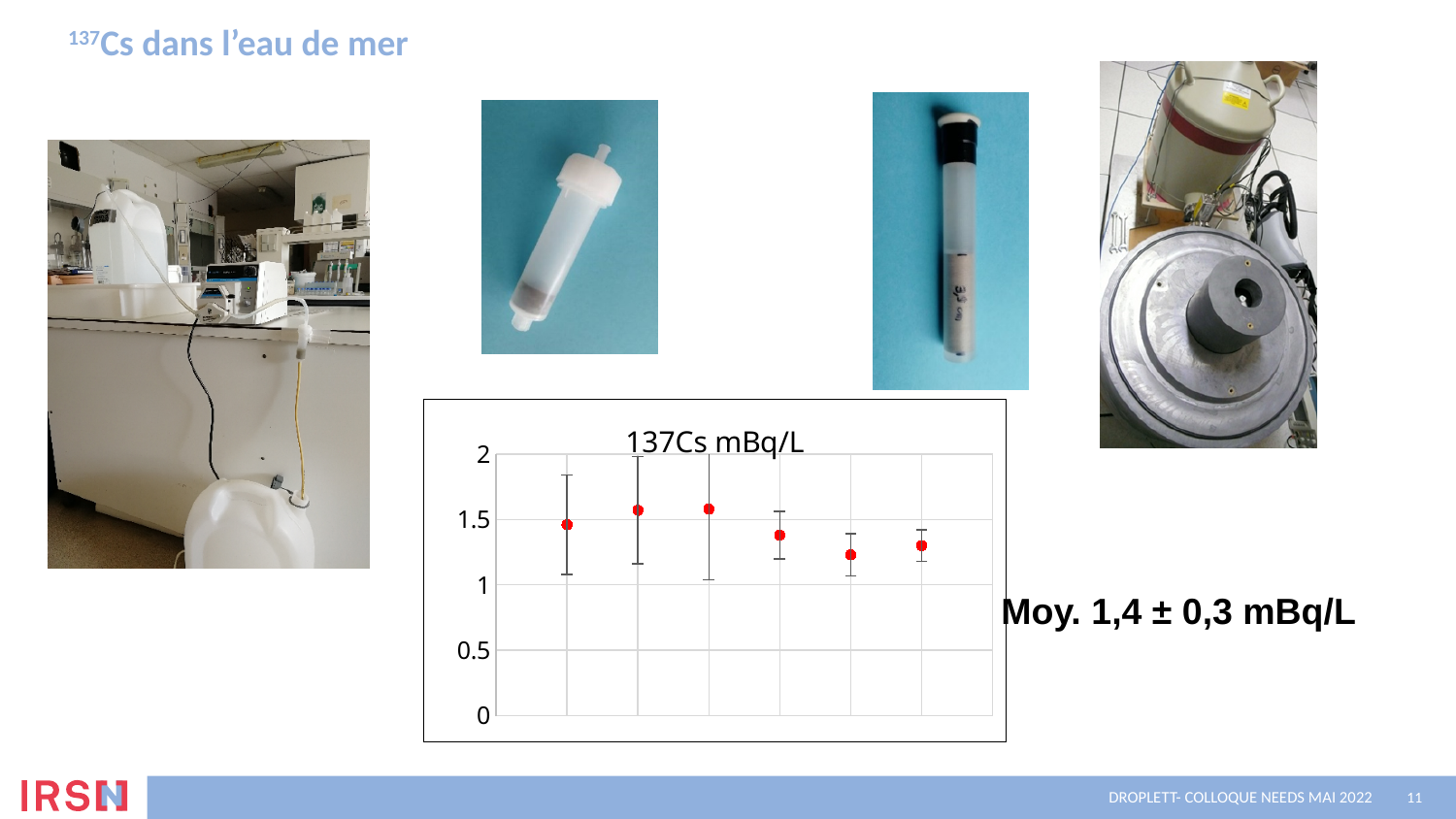
What kind of chart is shown on the slide? scatter chart with error bars How many data points are plotted in the chart? 6 What is the highest value shown on the y axis of the chart? 2 Do the plotted values overall rise or fall from left to right across the chart? fall Which is larger, the value of the second point from the left or the value of the fifth point from the left? the second point Is the value of the fifth point from the left greater or less than 1.5? less Is the value of the fourth point from the left greater or less than 1.5? less Is the value of the last (rightmost) point greater or less than 2? less What colour are the data point markers in the chart? red What is the title of the chart? 137Cs mBq/L Which is larger, the value of the fourth point from the left or the value of the fifth point from the left? the fourth point